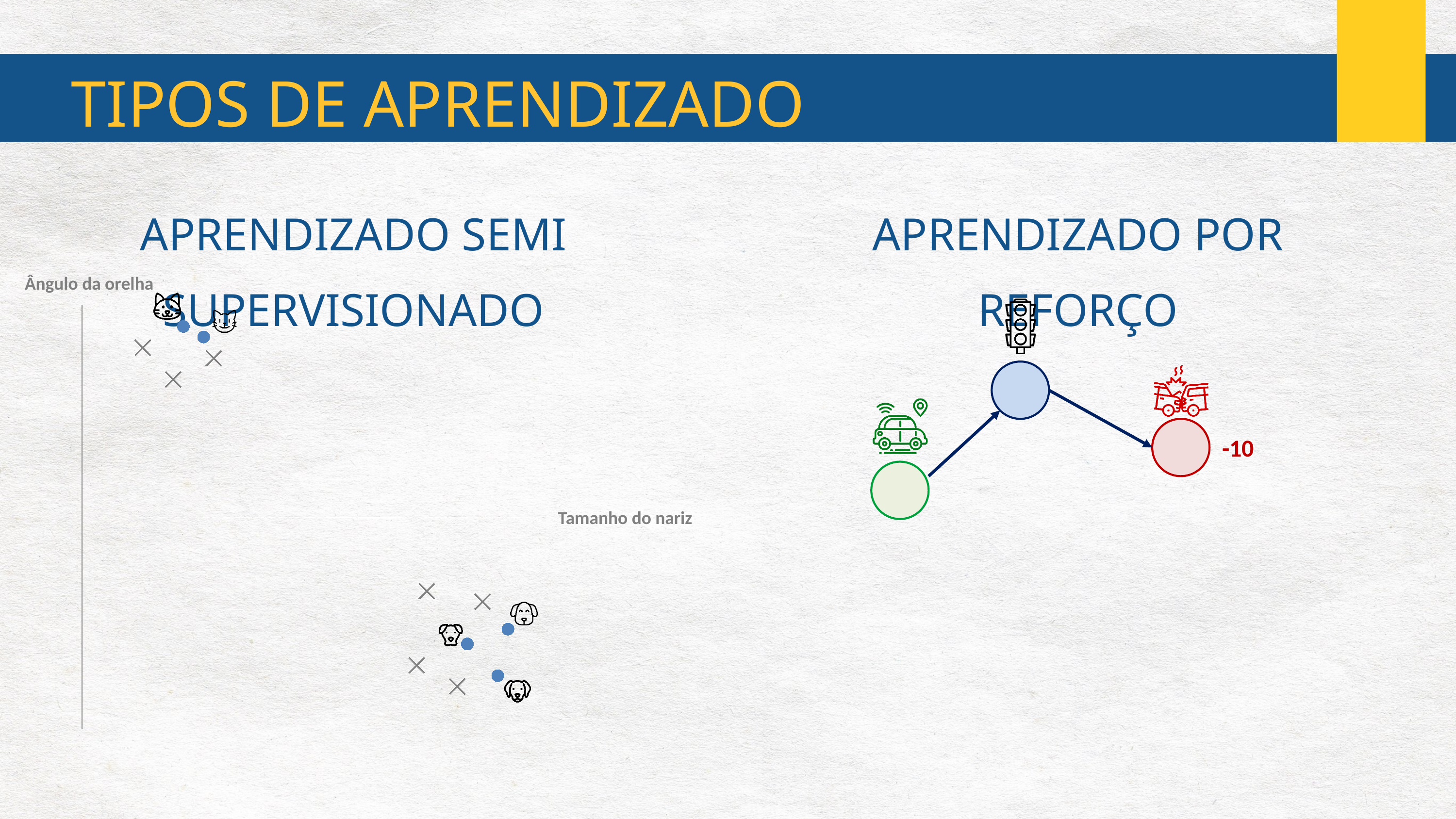
On the right diagram under 'Aprendizado por reforço', how many circles (states) are shown? 3 On the right diagram under 'Aprendizado por reforço', what value is written next to the red circle? -10 On the left chart, what is the label of the vertical axis? Ângulo da orelha On the left chart, which cluster has the higher 'Ângulo da orelha' values, the cat cluster or the dog cluster? cat cluster On the left chart, what is the label of the horizontal axis? Tamanho do nariz On the left chart under 'Aprendizado semi supervisionado', what kind of chart is shown? scatter chart On the left chart, how many separate clusters of points are shown? 2 On the left chart, which cluster has the larger 'Tamanho do nariz' values, the cat cluster or the dog cluster? dog cluster On the left chart, how many filled blue dots are plotted in total? 5